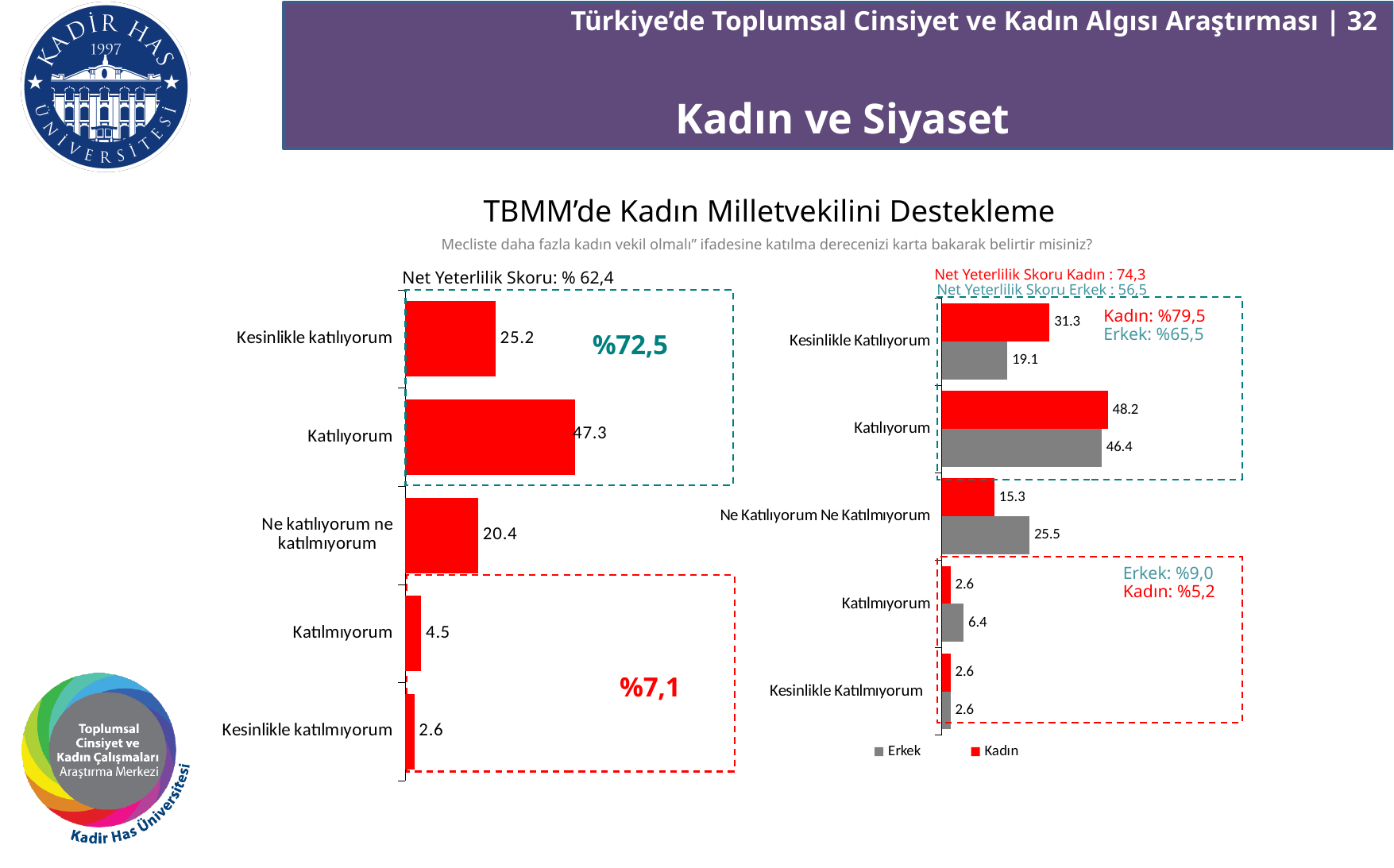
In the left chart, how many categories are shown? 5 What type of chart is the left chart? Bar chart In the left chart, which category has the highest value? Katılıyorum In the left chart, what is the difference between Katılıyorum and Kesinlikle katılıyorum? 22.1 In the right chart, which colour represents Kadın? Red In the right chart, which is larger for Katılmıyorum, Erkek or Kadın? Erkek In the right chart, how many series does the legend list? 2 In the right chart, what is the difference between the Kadın and Erkek values for Kesinlikle Katılıyorum? 12.2 In the left chart, which category has the lowest value? Kesinlikle katılmıyorum In the right chart, what is the Erkek value for Ne Katılıyorum Ne Katılmıyorum? 25.5 In the right chart, what is the Kadın value for Kesinlikle Katılıyorum? 31.3 In the left chart, what is the value for Katılıyorum? 47.3